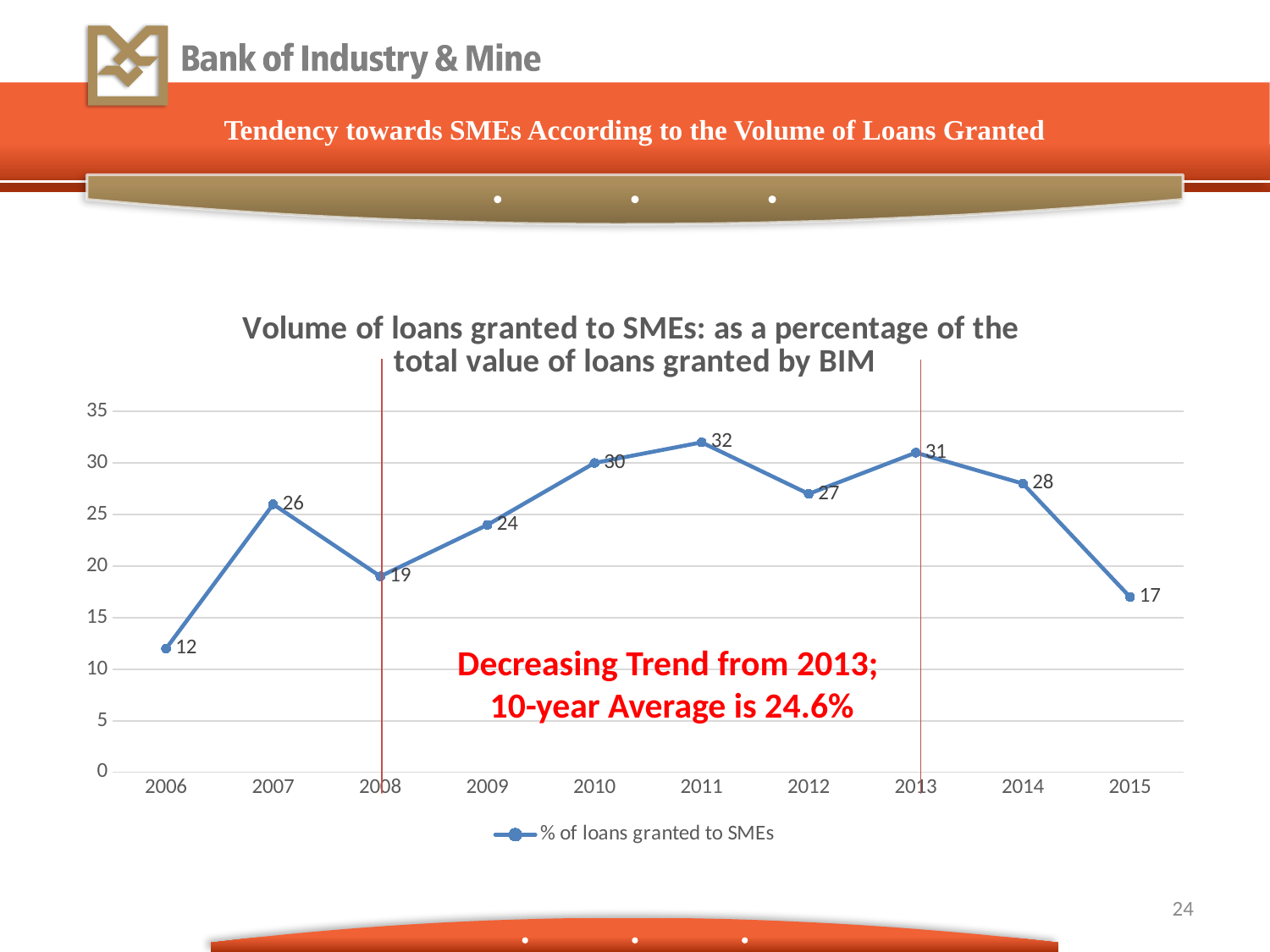
Which year has the lowest value? 2006 Which year has the highest value? 2011 Is the value for 2010 greater or less than 25? greater What is the value for 2011? 32 Do the values rise or fall from 2013 to 2015? fall How many series does the legend list? 1 What is the difference between the values for 2013 and 2015? 14 What is the value for 2006? 12 How many years are plotted on the x axis? 10 Which is larger, the value for 2007 or the value for 2012? 2012 What kind of chart is shown? line chart What is the value for 2015? 17